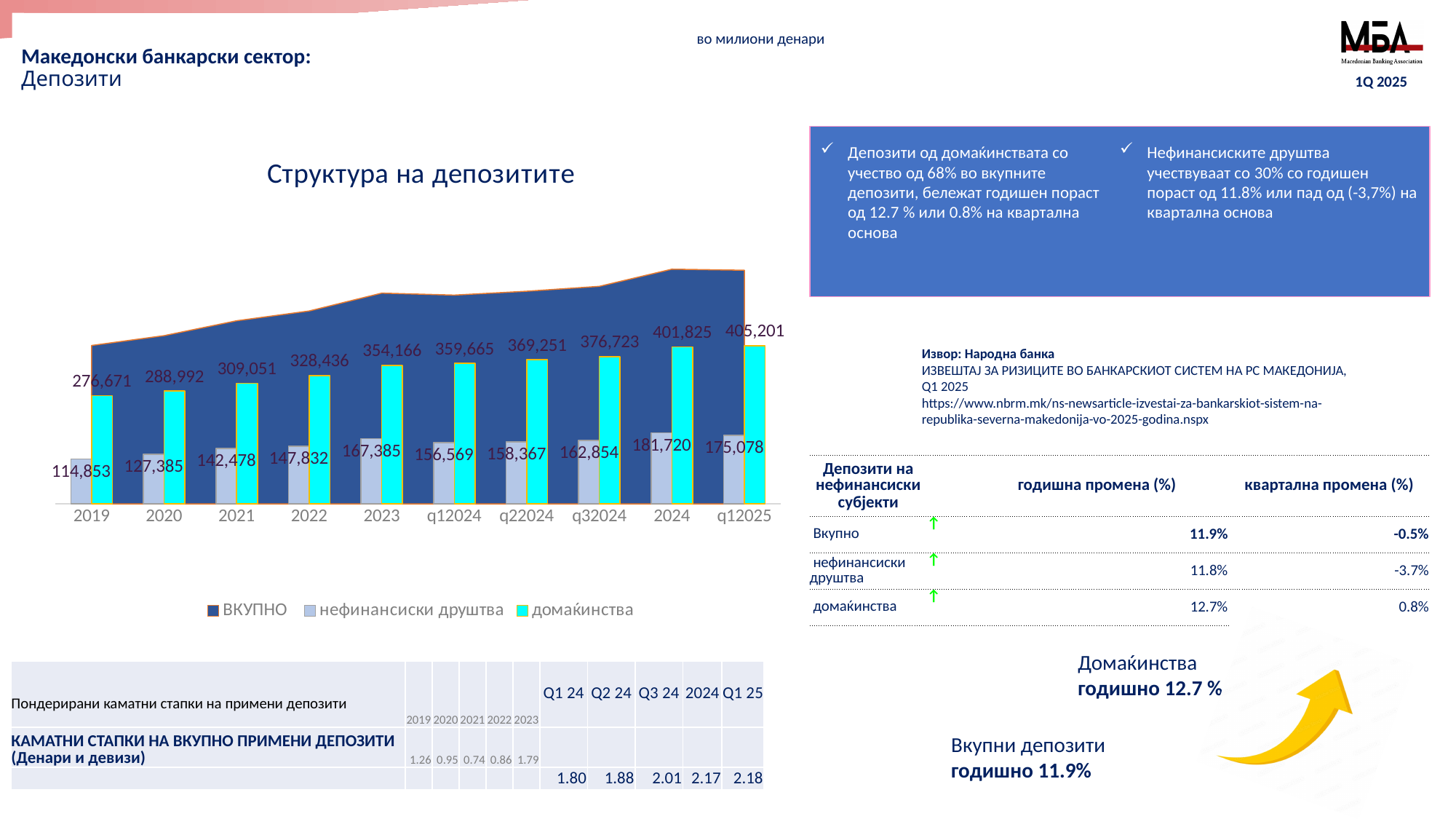
What is the value for нефинансиски друштва in q12024? 156,569 What is the title of the chart? Структура на депозитите What is the value for домаќинства in 2019? 276,671 How many series does the legend list? 3 How many periods are shown on the x axis? 10 What is the value for нефинансиски друштва in 2024? 181,720 What is the difference between the домаќинства values for q12025 and 2024? 3,376 Which is larger: нефинансиски друштва in 2023 or in q12024? 2023 Do the домаќинства values rise or fall from 2019 to q12025? rise In which period is the value for нефинансиски друштва highest? 2024 What is the value for домаќинства in q12025? 405,201 In which period is the value for домаќинства lowest? 2019